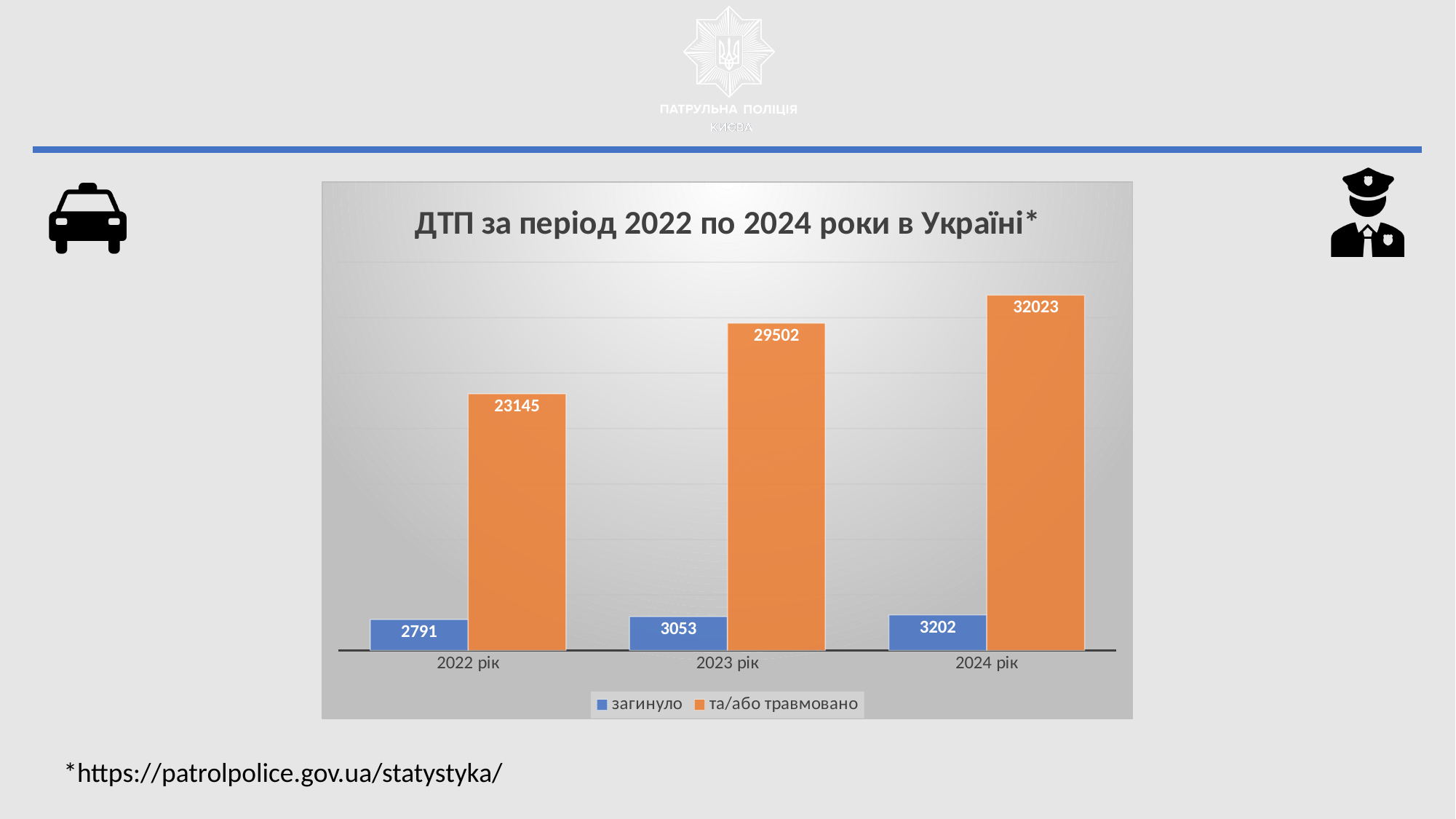
What kind of chart is shown on the slide? bar chart How many years are shown on the x axis? 3 What is the value for "та/або травмовано" in 2023 рік? 29502 What is the value for "загинуло" in 2022 рік? 2791 How many series does the legend list? 2 Do the "та/або травмовано" values rise or fall from 2022 рік to 2024 рік? rise Which year has the highest value for "та/або травмовано"? 2024 рік Which is larger: the "загинуло" value for 2023 рік or for 2024 рік? 2024 рік What is the value for "та/або травмовано" in 2024 рік? 32023 What is the value for "загинуло" in 2024 рік? 3202 What is the difference between the "та/або травмовано" values for 2024 рік and 2022 рік? 8878 Which year has the lowest value for "загинуло"? 2022 рік